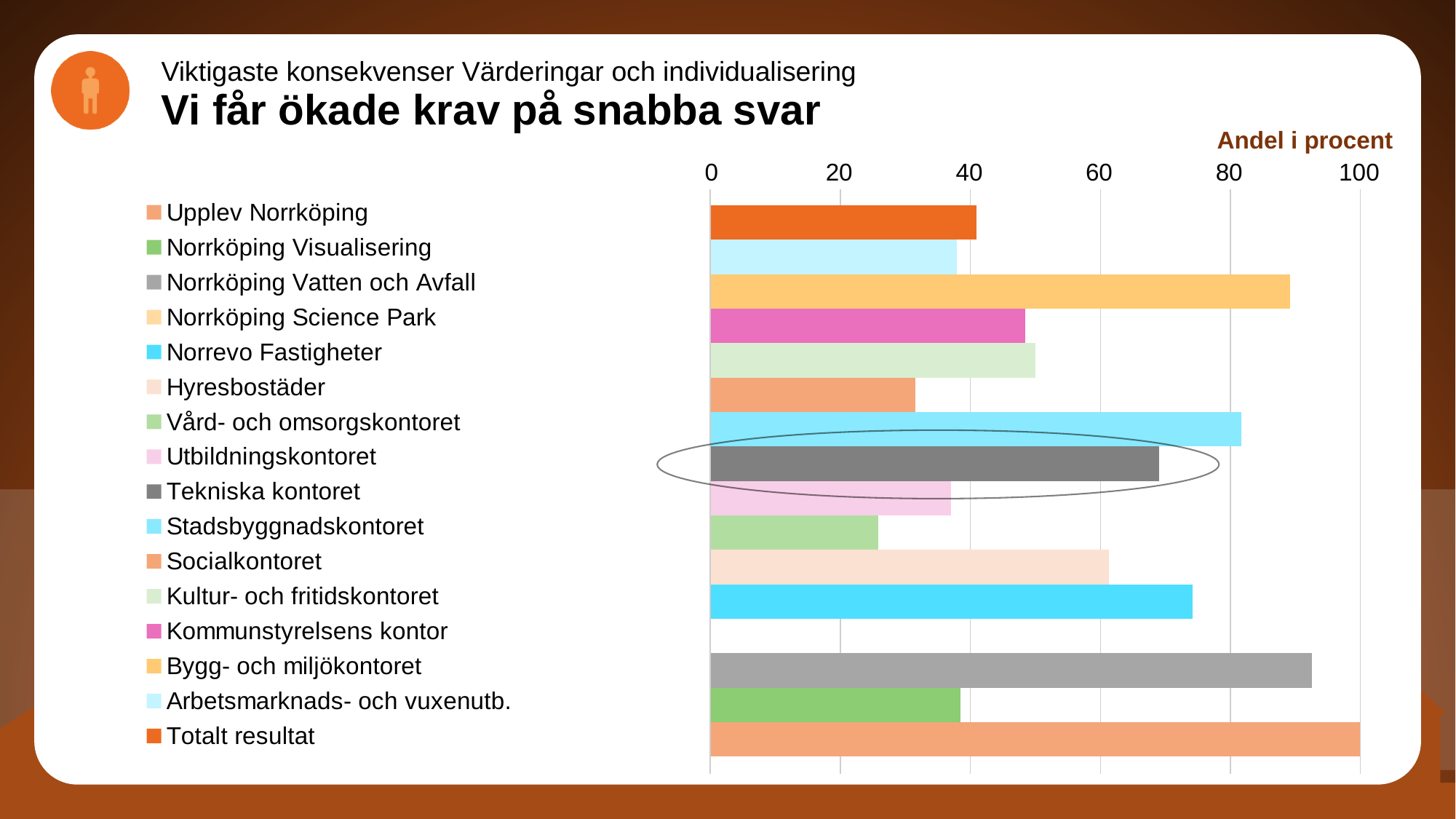
Is the value for Bygg- och miljökontoret greater or less than 80? greater What is the title of the chart's horizontal axis? Andel i procent What is the value for Upplev Norrköping? 100 Which category has the highest value in the chart? Upplev Norrköping Which is larger, the value for Vård- och omsorgskontoret or the value for Hyresbostäder? Hyresbostäder Is the value for Socialkontoret greater or less than 40? less Which is larger, the value for Norrköping Vatten och Avfall or the value for Stadsbyggnadskontoret? Norrköping Vatten och Avfall Is the value for Tekniska kontoret greater or less than 60? greater How many categories are plotted in the chart? 16 How many entries does the chart legend list? 16 What kind of chart is shown on the slide? bar chart